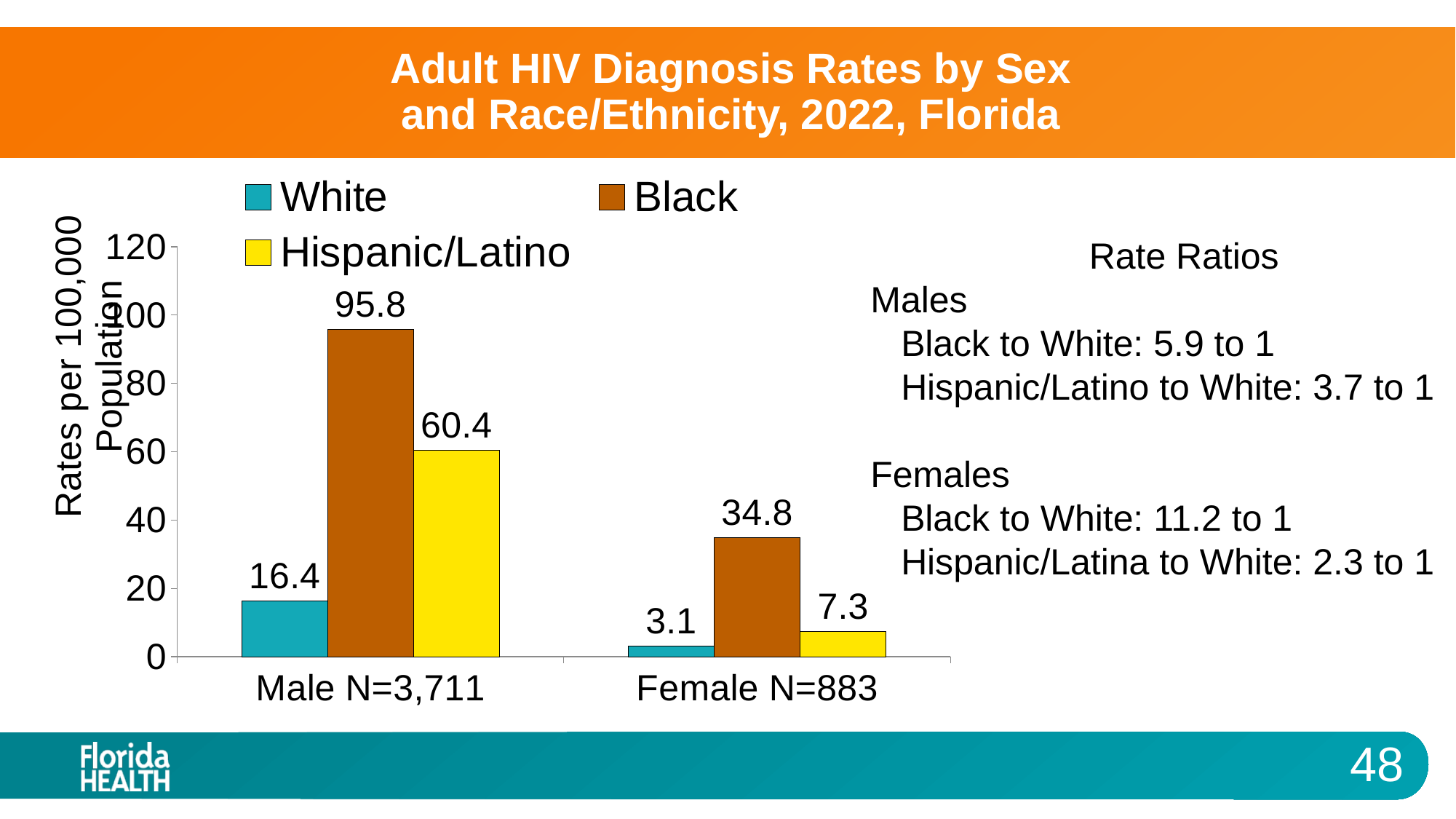
How many series does the legend list? 3 What is the HIV diagnosis rate for White females? 3.1 What is the HIV diagnosis rate for Hispanic/Latino males? 60.4 Is the value for Hispanic/Latino males greater or less than 40? greater Which race/ethnicity group has the highest diagnosis rate among females? Black What is the y-axis label of the chart? Rates per 100,000 Population What kind of chart is shown on the slide? Bar chart Which race/ethnicity group has the lowest diagnosis rate among males? White What is the difference between the Black male rate and the Black female rate? 61 What is the HIV diagnosis rate for Black males? 95.8 How many sex categories are shown on the x axis? 2 Which is larger, the Hispanic/Latino female rate or the White male rate? White male rate